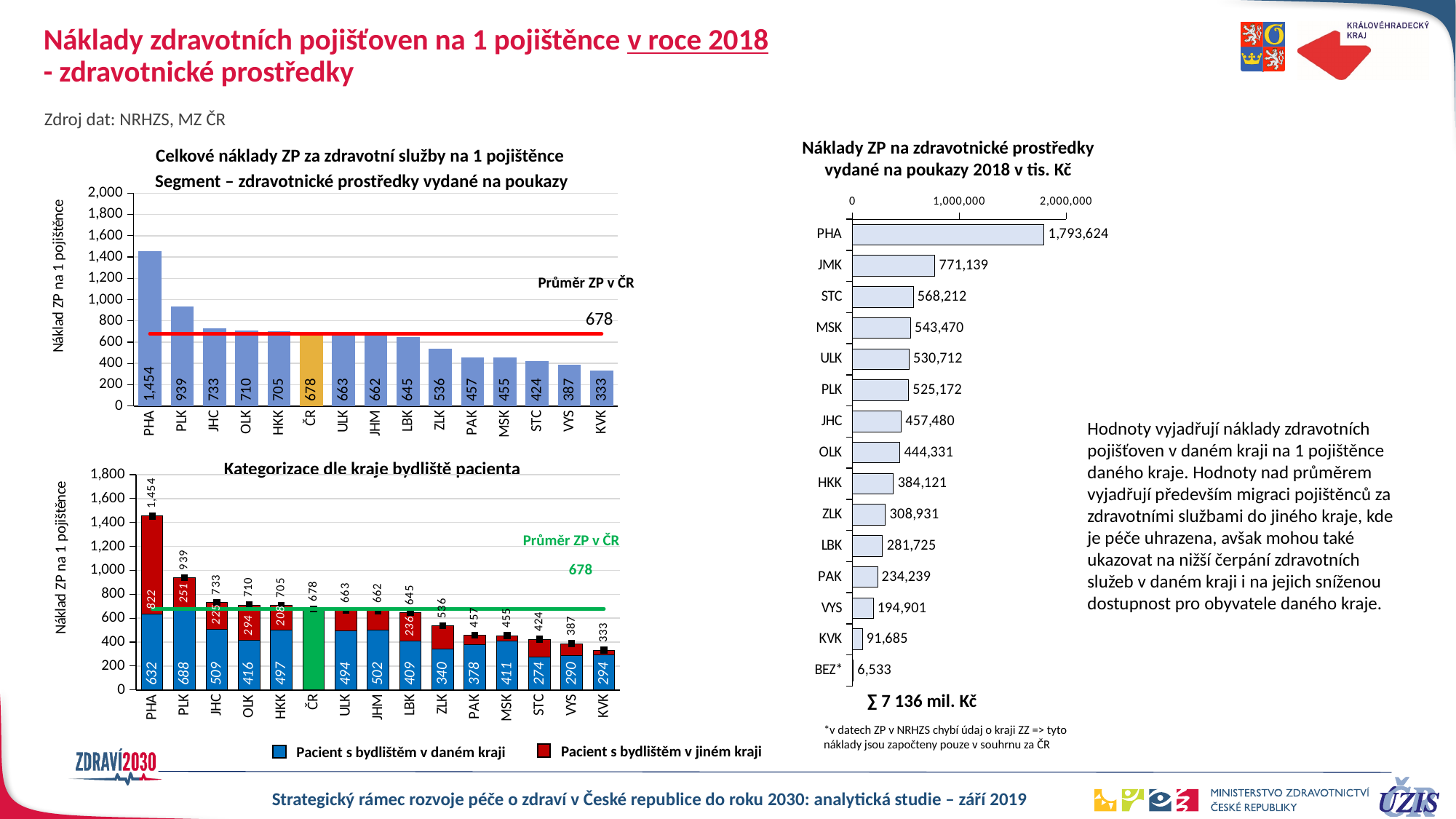
In the right chart 'Náklady ZP na zdravotnické prostředky vydané na poukazy 2018 v tis. Kč', what is the value for JMK? 771,139 In the bottom-left chart 'Kategorizace dle kraje bydliště pacienta', what is the value for 'Pacient s bydlištěm v jiném kraji' for OLK? 294 In the top-left chart 'Celkové náklady ZP za zdravotní služby na 1 pojištěnce', what is the value for PHA? 1,454 In the top-left chart 'Celkové náklady ZP za zdravotní služby na 1 pojištěnce', what is the difference between the values for PLK and JHC? 206 In the top-left chart 'Celkové náklady ZP za zdravotní služby na 1 pojištěnce', how many bars are plotted? 15 In the right chart 'Náklady ZP na zdravotnické prostředky vydané na poukazy 2018 v tis. Kč', which region has the highest value? PHA What type of chart is the right chart 'Náklady ZP na zdravotnické prostředky vydané na poukazy 2018 v tis. Kč'? Bar chart In the top-left chart 'Celkové náklady ZP za zdravotní služby na 1 pojištěnce', which region has the lowest value? KVK In the bottom-left chart 'Kategorizace dle kraje bydliště pacienta', how many series does the legend list? 2 In the top-left chart 'Celkové náklady ZP za zdravotní služby na 1 pojištěnce', what is the value shown for the ČR average (Průměr ZP v ČR)? 678 In the bottom-left chart 'Kategorizace dle kraje bydliště pacienta', what is the value for 'Pacient s bydlištěm v daném kraji' for PHA? 632 In the bottom-left chart 'Kategorizace dle kraje bydliště pacienta', what is the total of the stacked bar for LBK? 645